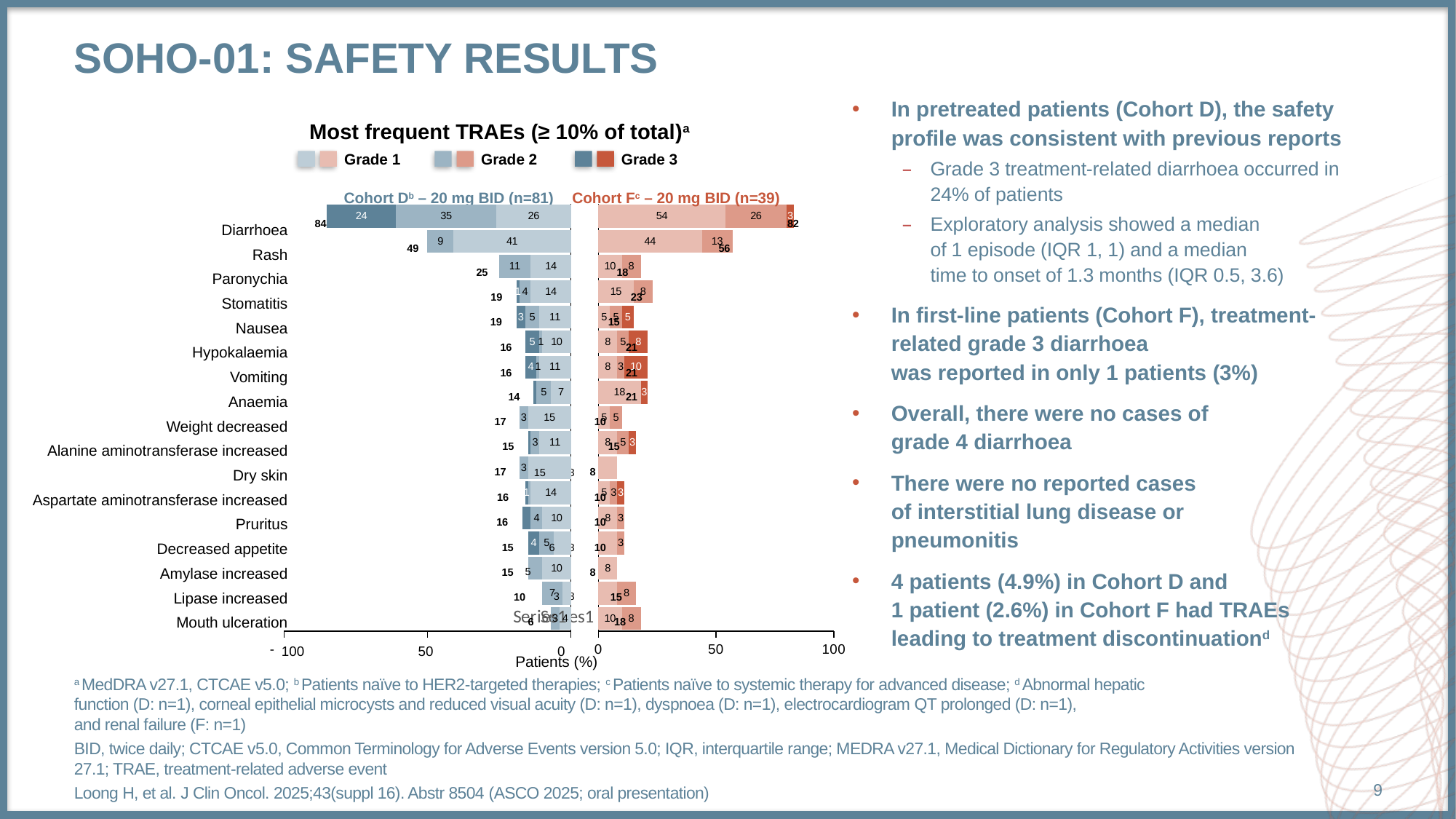
How many grade levels does the chart legend list? 3 How many treatment-related adverse events (categories) are listed on the y axis of the chart? 17 In the Cohort D bars, which adverse event has the highest total percentage? Diarrhoea What is the label of the x axis of the chart? Patients (%) In the Cohort F bars, what is the total percentage of patients with diarrhoea? 82 In the Cohort F bars, what is the Grade 3 value for diarrhoea? 3 In the Cohort D bars, which adverse event has the lowest total percentage? Mouth ulceration What kind of chart is shown on the slide? Bar chart What is the difference between the total rash percentage in Cohort F (56) and in Cohort D (49)? 7 In the Cohort D bars, what is the total percentage of patients with diarrhoea? 84 In the Cohort D bars, what is the Grade 1 value for rash? 41 In the Cohort D bars, what is the Grade 3 value for diarrhoea? 24